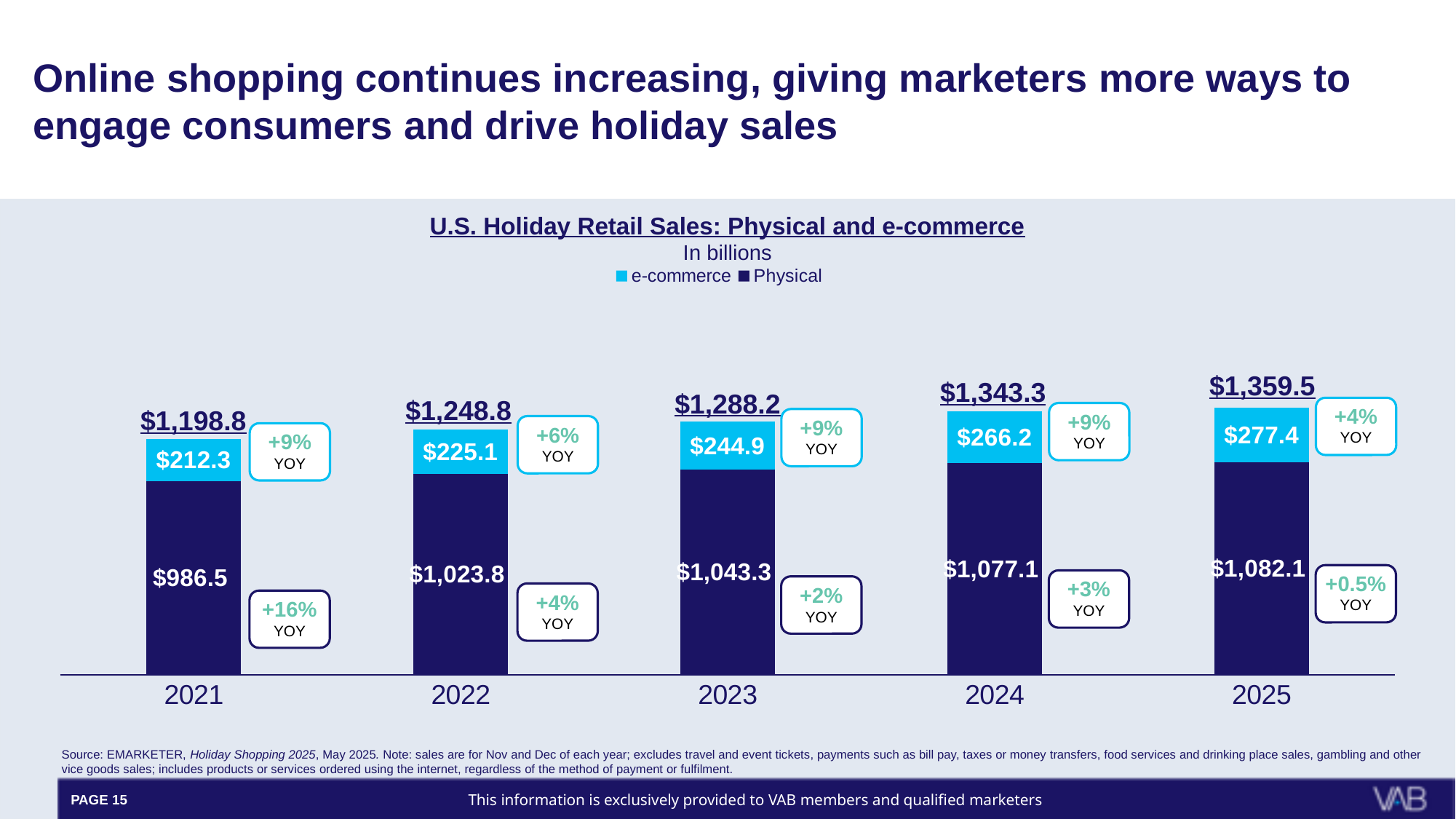
What kind of chart is this? Stacked bar chart Which year has the highest Physical value? 2025 Which is larger, the Physical value for 2022 or the Physical value for 2023? 2023 What is the Physical value for 2021? $986.5 What is the total holiday retail sales value shown for 2025? $1,359.5 What is the e-commerce value for 2023? $244.9 What is the YOY change shown for e-commerce in 2021? +9% Which year has the lowest e-commerce value? 2021 What is the difference between the e-commerce values for 2025 and 2024? $11.2 How many series does the legend list? 2 How many years are shown on the x axis? 5 Do the total values rise or fall from 2021 to 2025? Rise